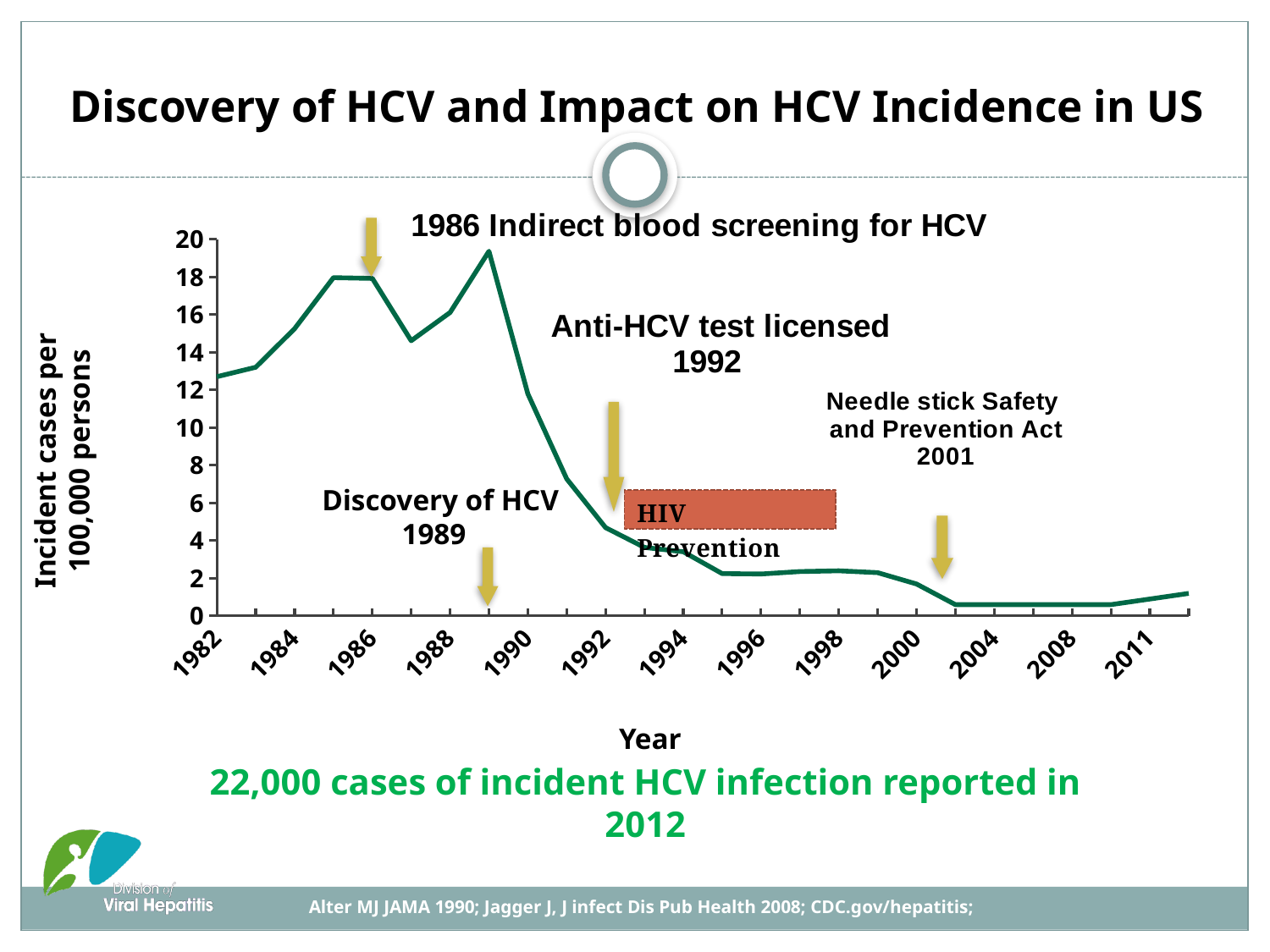
What is the title of the chart on the slide? Discovery of HCV and Impact on HCV Incidence in US Which is larger, the value for 1982 or the value for 2011? 1982 Do the values rise or fall between 1990 and 2004? fall How many year labels are shown along the x axis? 13 Is the value for 1992 greater or less than 6? less Is the value for 1982 greater or less than 10? greater How many data series are plotted on the chart? 1 What kind of chart is shown on the slide? line chart What is the label of the y axis? Incident cases per 100,000 persons Is the value for 1986 greater or less than 16? greater